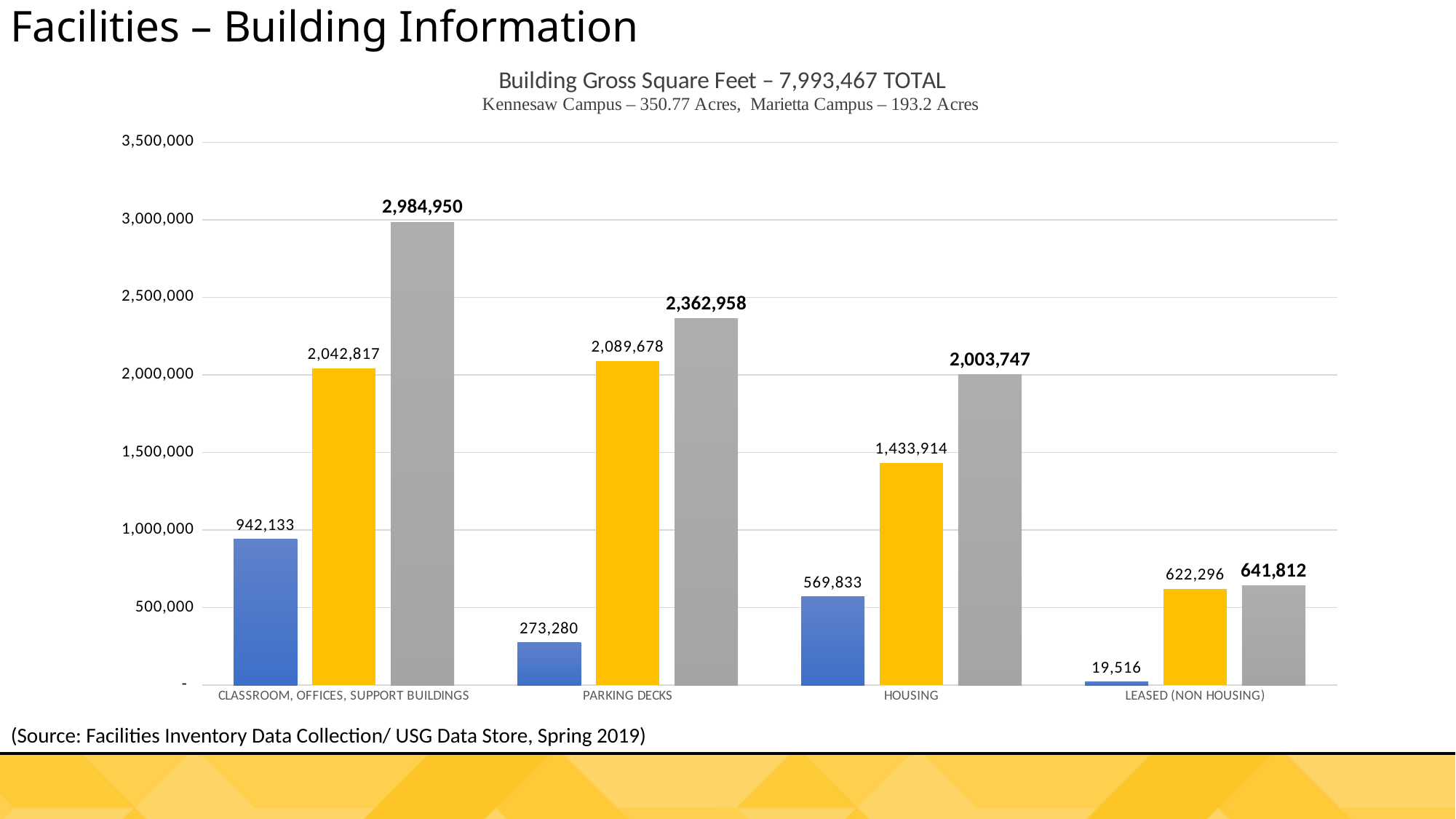
Which is larger: the blue bar for Housing or the blue bar for Parking Decks? Housing What kind of chart is shown on the slide? bar chart What is the value of the gray bar for Parking Decks? 2,362,958 What total is stated in the chart title? 7,993,467 Which category has the lowest blue bar? Leased (Non Housing) Is the yellow bar for Leased (Non Housing) greater or less than 1,000,000? less What is the value of the blue bar for Classroom, Offices, Support Buildings? 942,133 Which category has the highest gray bar? Classroom, Offices, Support Buildings What is the difference between the gray bar for Classroom, Offices, Support Buildings and the gray bar for Parking Decks? 621,992 What is the value of the blue bar for Leased (Non Housing)? 19,516 What is the value of the yellow bar for Housing? 1,433,914 How many categories are shown on the x axis? 4